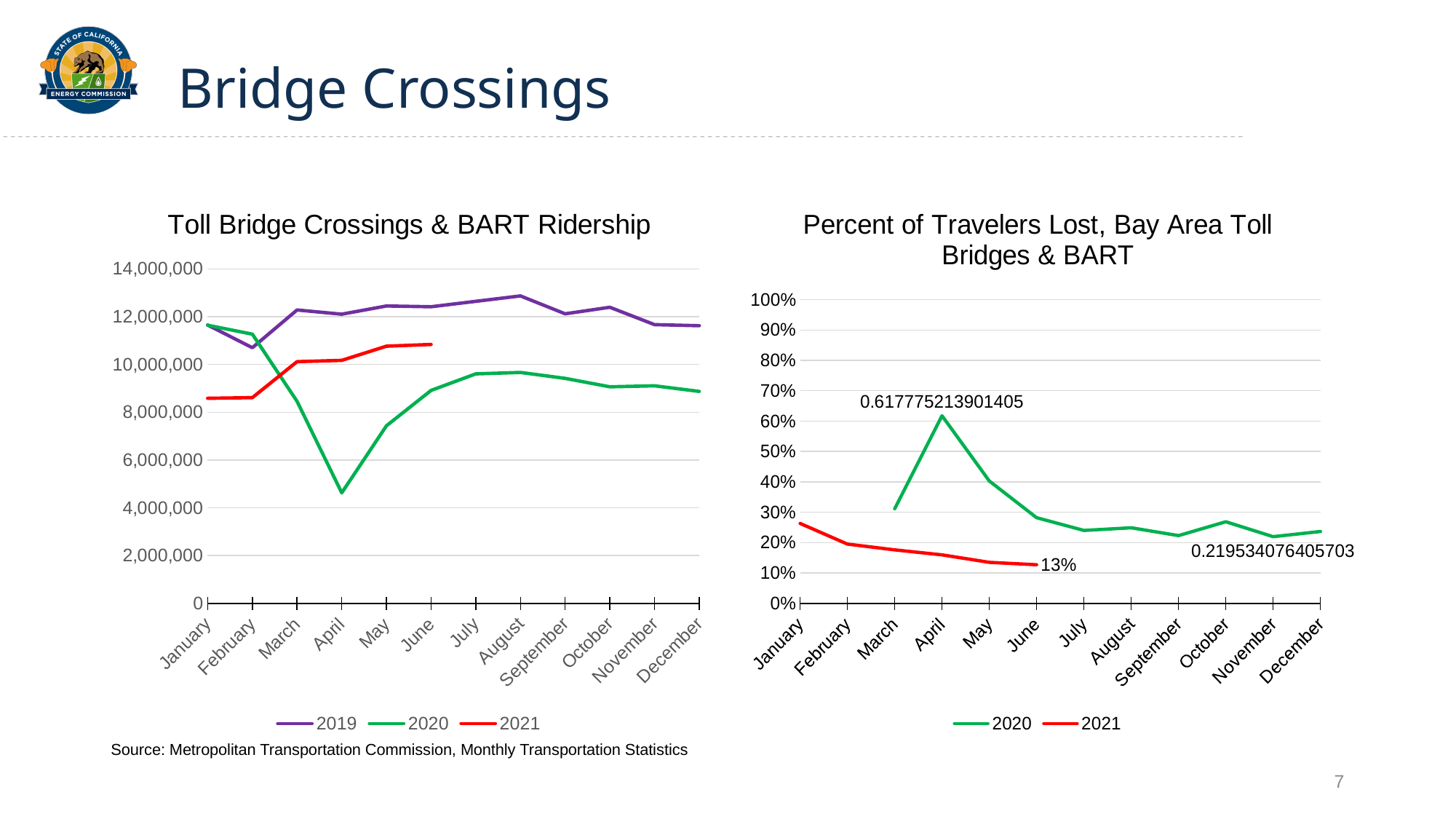
In the 'Toll Bridge Crossings & BART Ridership' chart, is the 2020 value for April greater or less than 6,000,000? less In the 'Toll Bridge Crossings & BART Ridership' chart, which series is higher in August, 2019 or 2020? 2019 How many series does the legend of the 'Toll Bridge Crossings & BART Ridership' chart list? 3 In the 'Percent of Travelers Lost, Bay Area Toll Bridges & BART' chart, what is the labeled value for 2020 in April? 0.617775213901405 How many months are shown on the x axis of the 'Toll Bridge Crossings & BART Ridership' chart? 12 What kind of chart is the 'Toll Bridge Crossings & BART Ridership' chart? Line chart In the 'Toll Bridge Crossings & BART Ridership' chart, in which month does the 2020 line reach its lowest value? April In the 'Percent of Travelers Lost, Bay Area Toll Bridges & BART' chart, in which month does the 2020 line reach its highest value? April In the 'Percent of Travelers Lost, Bay Area Toll Bridges & BART' chart, what is the labeled value for 2021 in June? 13% How many series does the legend of the 'Percent of Travelers Lost, Bay Area Toll Bridges & BART' chart list? 2 In the 'Percent of Travelers Lost, Bay Area Toll Bridges & BART' chart, does the 2021 line rise or fall from January to June? Fall